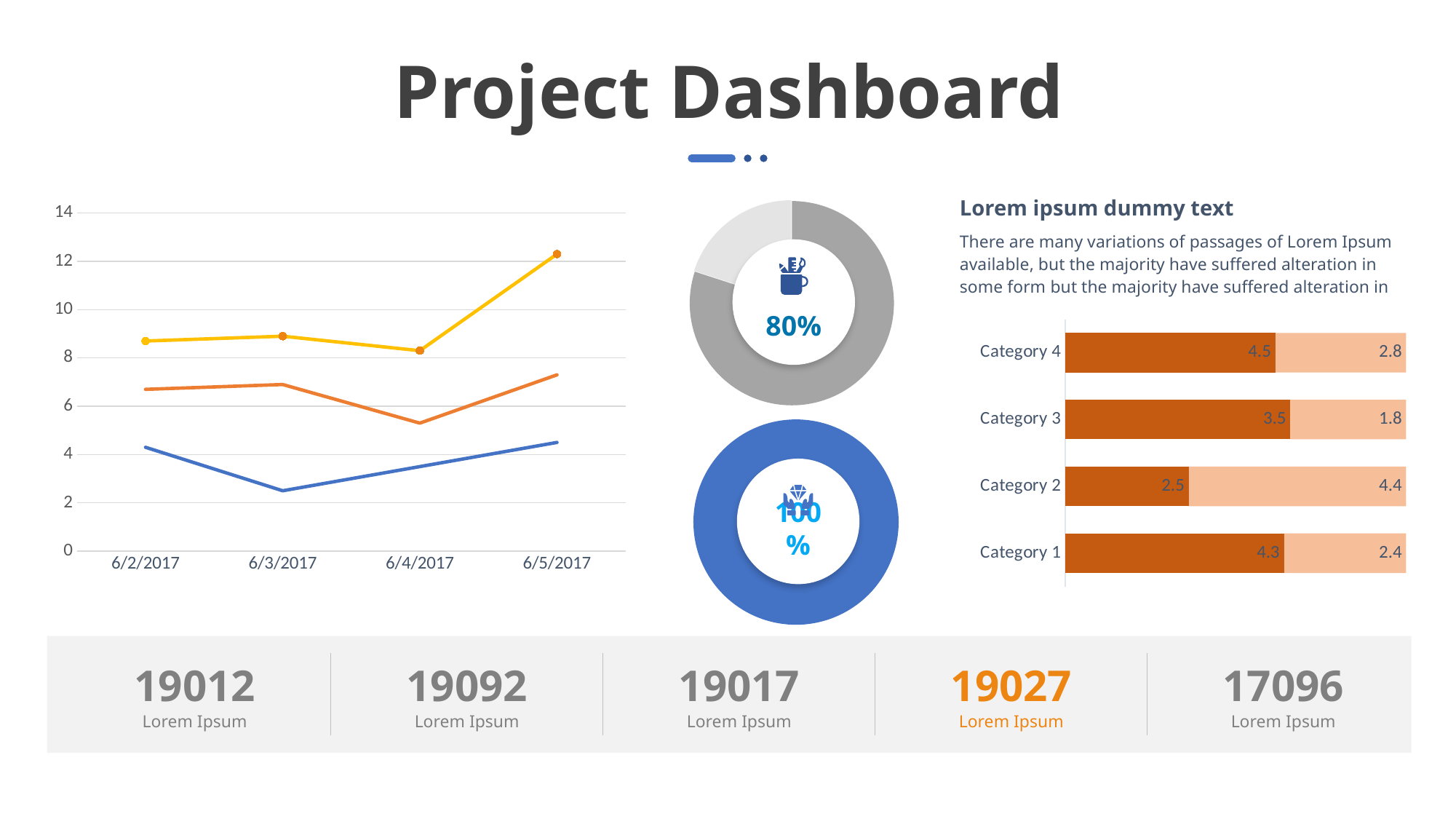
In the stacked bar chart on the right, which category has the smallest light orange segment? Category 3 In the stacked bar chart on the right, what is the total of the Category 1 bar? 6.7 In the stacked bar chart on the right, what is the value of the light orange segment for Category 2? 4.4 In the stacked bar chart on the right, what is the total of the Category 3 bar? 5.3 In the stacked bar chart on the right, how many categories are shown? 4 In the line chart on the left, is the value of the blue line at 6/3/2017 greater or less than 4? less In the stacked bar chart on the right, what is the value of the dark orange segment for Category 4? 4.5 What kind of chart is the chart on the left of the slide? Line chart In the line chart on the left, is the value of the yellow line at 6/2/2017 greater or less than 8? greater In the stacked bar chart on the right, what is the difference between the dark orange values of Category 4 and Category 2? 2.0 What percentage is shown in the centre of the grey donut chart? 80% In the stacked bar chart on the right, which category has the largest dark orange segment? Category 4